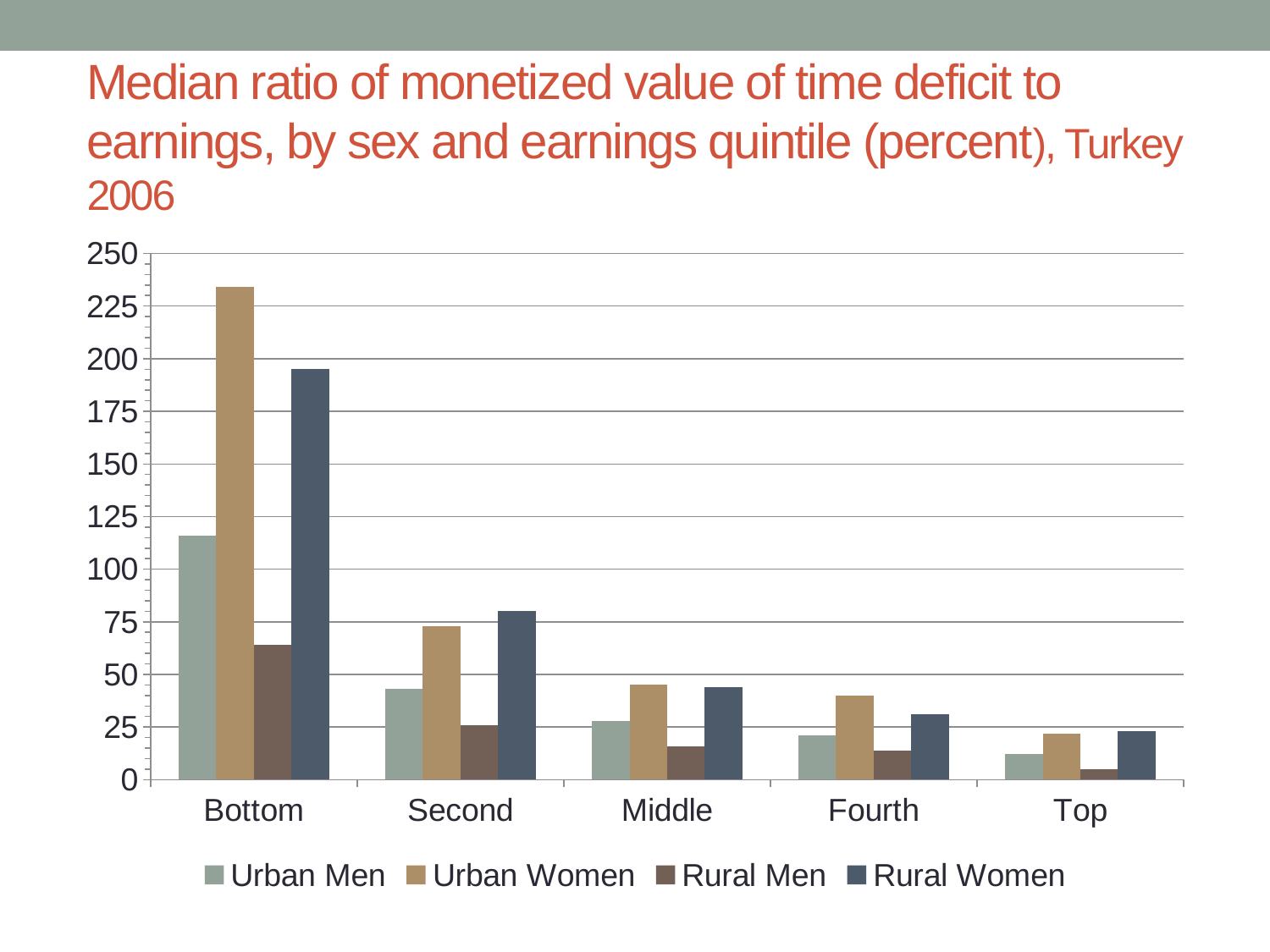
Do the values for Urban Men rise or fall moving from the Bottom quintile to the Top quintile? fall Is the value for Rural Women in the Bottom quintile greater or less than 175? greater Which earnings quintile has the lowest value for Rural Men? Top What kind of chart is shown on the slide? bar chart How many series does the legend list? 4 In the Bottom quintile, which is larger: the value for Urban Women or the value for Rural Women? Urban Women Which earnings quintile has the highest value for Urban Women? Bottom Is the value for Rural Men in the Second quintile greater or less than 50? less How many earnings quintile categories are shown on the x axis? 5 Is the value for Urban Women in the Bottom quintile greater or less than 225? greater Which series is shown in the darkest blue-grey colour in the legend? Rural Women